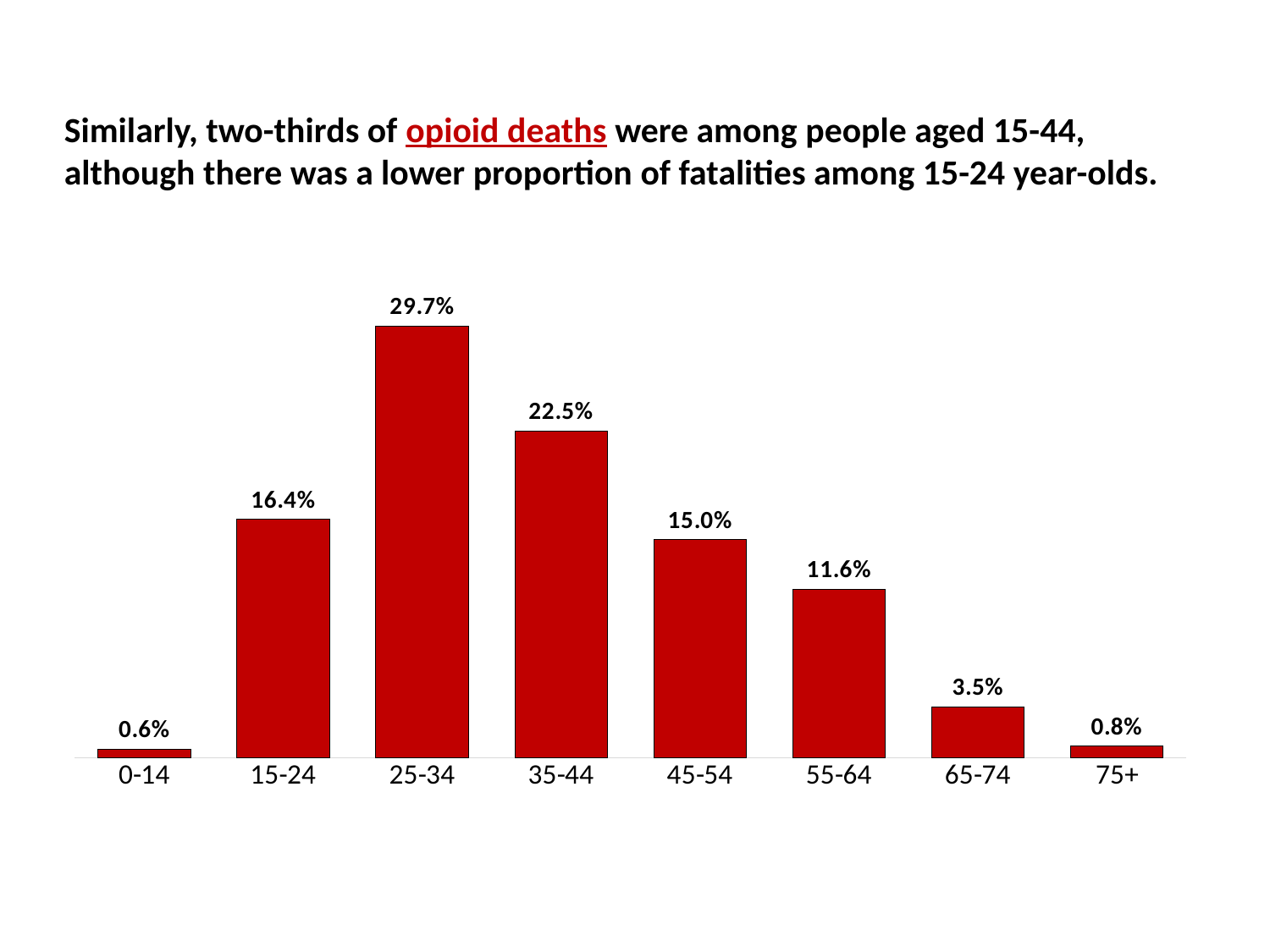
Which age group has a larger value, 0-14 or 75+? 75+ What is the difference between the values for the 25-34 and 35-44 age groups? 7.2% Which age group has a larger value, 15-24 or 45-54? 15-24 Which age group has the lowest percentage of opioid deaths? 0-14 Which age group has the highest percentage of opioid deaths? 25-34 What is the value shown for the 65-74 age group? 3.5% What is the value shown for the 45-54 age group? 15.0% What is the difference between the values for the 15-24 and 55-64 age groups? 4.8% What kind of chart is shown on the slide? Bar chart What percentage of opioid deaths were among people aged 25-34? 29.7% What is the combined percentage for the 15-24, 25-34 and 35-44 age groups? 68.6% How many age groups are shown on the chart? 8